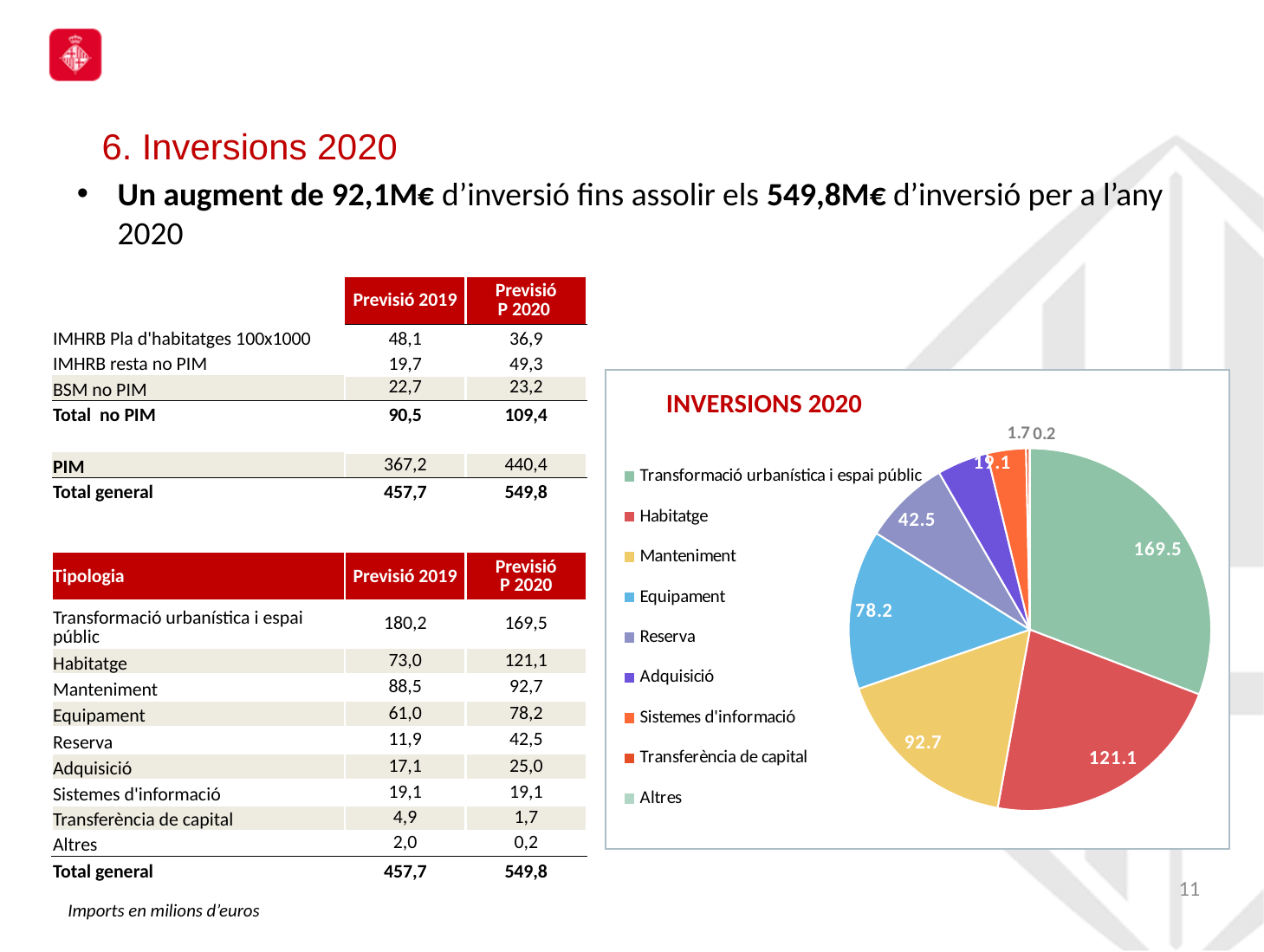
How many categories does the legend of the INVERSIONS 2020 pie chart list? 9 In the INVERSIONS 2020 pie chart, what is the value for Equipament? 78.2 In the INVERSIONS 2020 pie chart, what is the value for Manteniment? 92.7 Which category has the smallest slice in the INVERSIONS 2020 pie chart? Altres In the INVERSIONS 2020 pie chart, what is the value for Reserva? 42.5 In the INVERSIONS 2020 pie chart, what is the difference between the values for Transformació urbanística i espai públic and Habitatge? 48.4 Which category has the largest slice in the INVERSIONS 2020 pie chart? Transformació urbanística i espai públic What is the title of the chart? INVERSIONS 2020 In the INVERSIONS 2020 pie chart, which is larger: Manteniment or Equipament? Manteniment In the INVERSIONS 2020 pie chart, what is the value for Transformació urbanística i espai públic? 169.5 In the INVERSIONS 2020 pie chart, what is the value for Habitatge? 121.1 What kind of chart is shown on the slide? pie chart